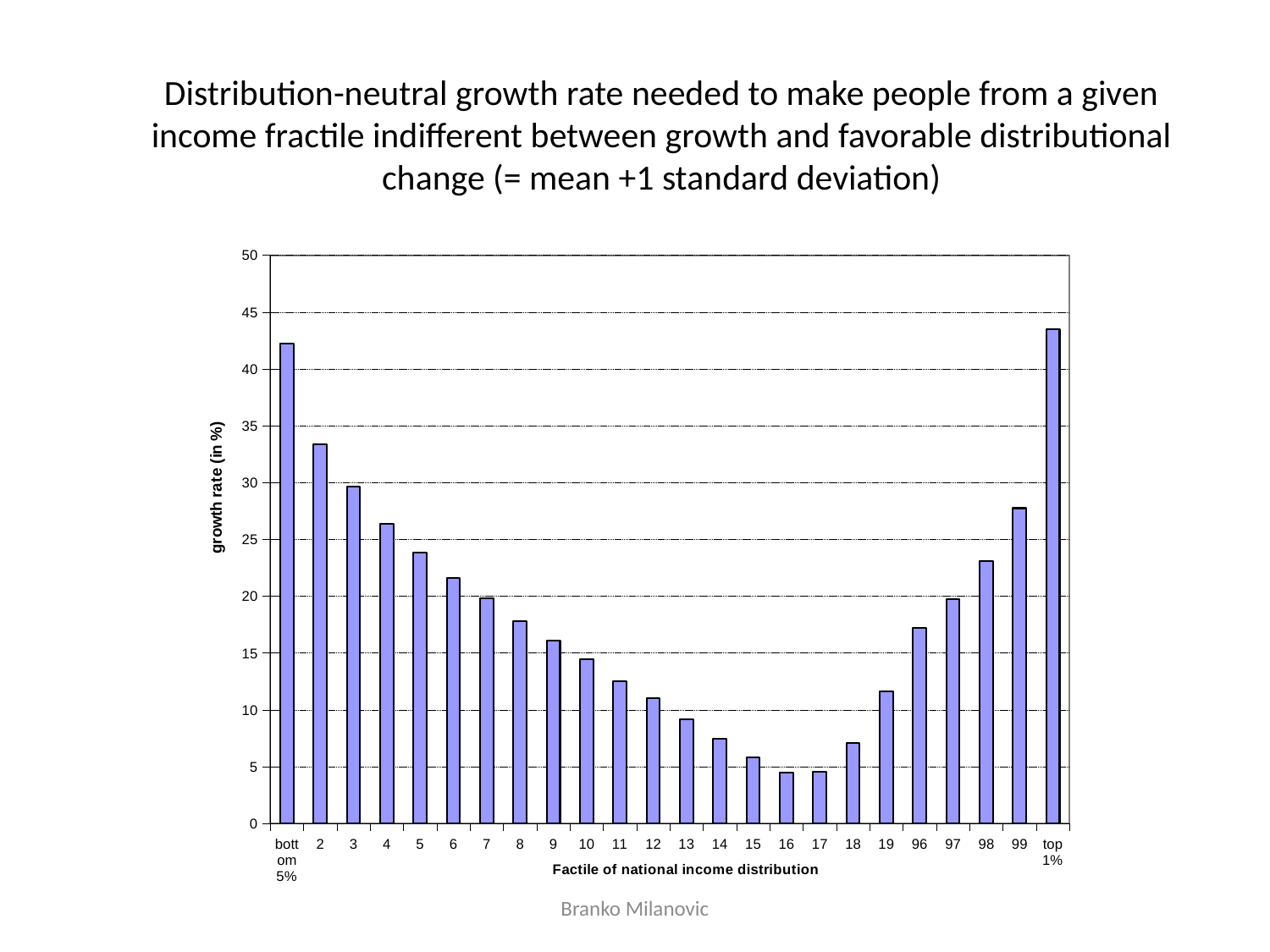
How many fractile categories are plotted along the x axis? 24 Do the growth rates rise or fall from the bottom 5% to fractile 16? fall Which has the larger growth rate, fractile 99 or fractile 98? 99 What is the title of the y axis? growth rate (in %) Is the growth rate for the bottom 5% greater or less than 40? greater Is the growth rate for fractile 98 greater or less than 20? greater Is the growth rate for fractile 10 greater or less than 15? less Which fractile has the highest growth rate? top 1% Which has the larger growth rate, the bottom 5% or fractile 2? bottom 5% What kind of chart is shown on the slide? bar chart